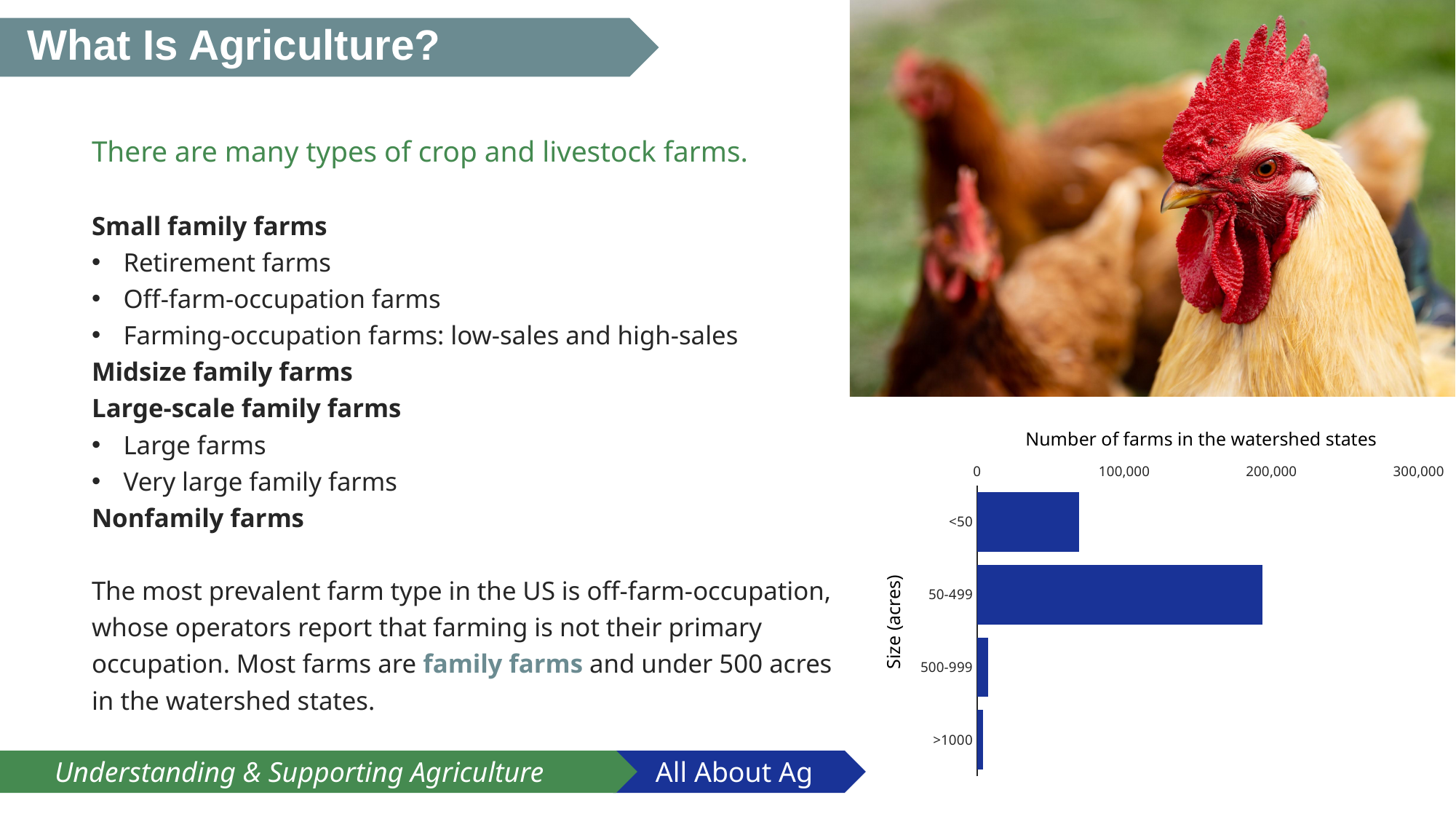
What kind of chart is shown on the slide? bar chart Is the number of farms for the >1000 acres category greater or less than 100,000? less How many farm size categories are shown in the chart? 4 What is the title of the chart? Number of farms in the watershed states Is the number of farms for the 500-999 acres category greater or less than 100,000? less What is the label of the vertical axis of the chart? Size (acres) Which has more farms, the <50 category or the 50-499 category? 50-499 Is the number of farms for the 50-499 acres category greater or less than 100,000? greater What is the highest value shown on the horizontal axis of the chart? 300,000 Which has more farms, the <50 category or the 500-999 category? <50 Which farm size category has the highest number of farms? 50-499